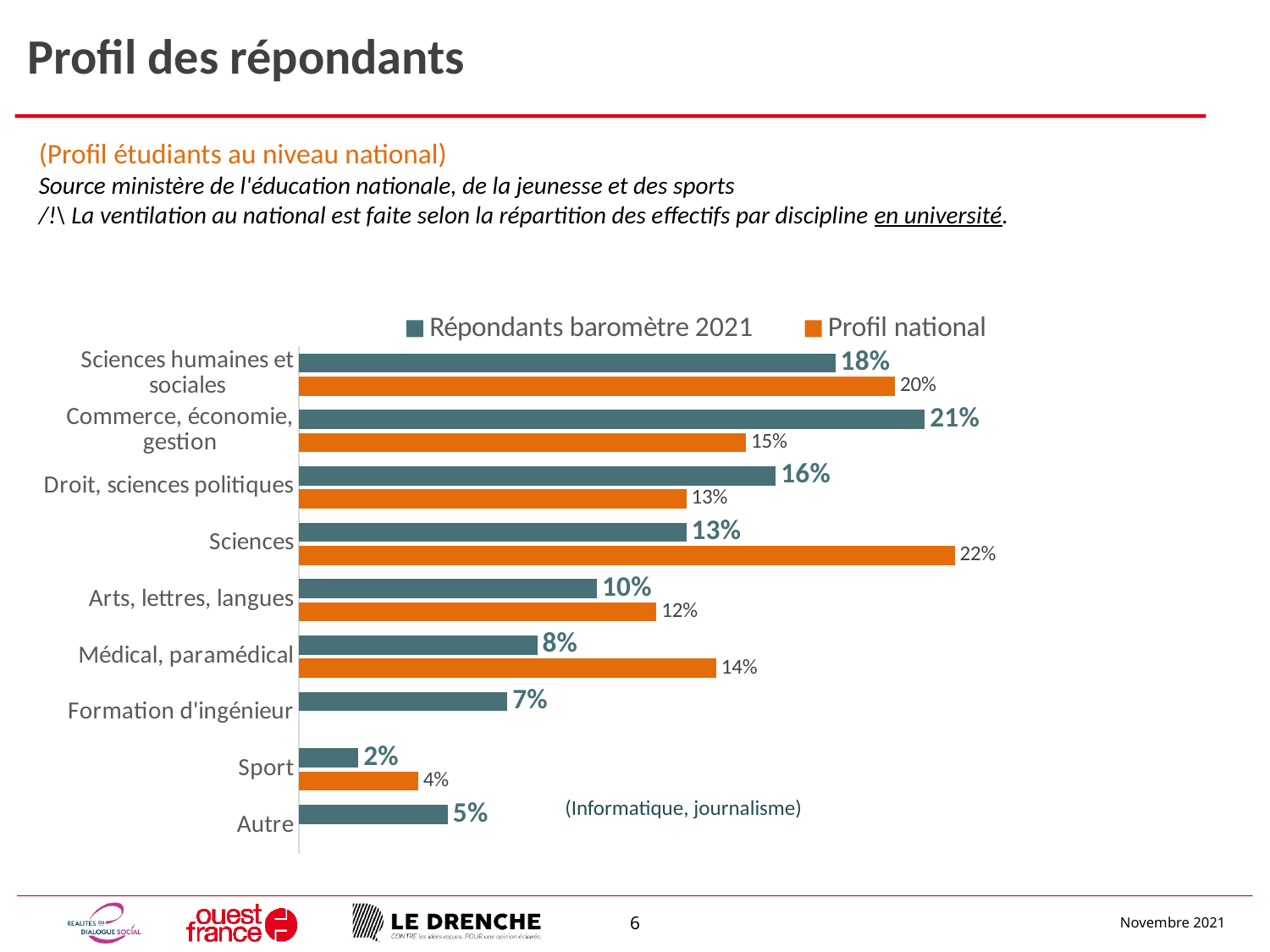
Which category has the highest Profil national value? Sciences What colour are the Profil national bars? Orange Which category has the highest value in the Répondants baromètre 2021 series? Commerce, économie, gestion What is the Profil national value for Sciences? 22% What is the Profil national value for Médical, paramédical? 14% Which category has the lowest value in the Répondants baromètre 2021 series? Sport What is the value for Commerce, économie, gestion in the Répondants baromètre 2021 series? 21% What is the difference between the Profil national and Répondants baromètre 2021 values for Sciences? 9% How many categories are shown on the chart? 9 What kind of chart is shown on the slide? Bar chart How many series does the legend list? 2 For Droit, sciences politiques, which is larger: the Répondants baromètre 2021 value or the Profil national value? Répondants baromètre 2021